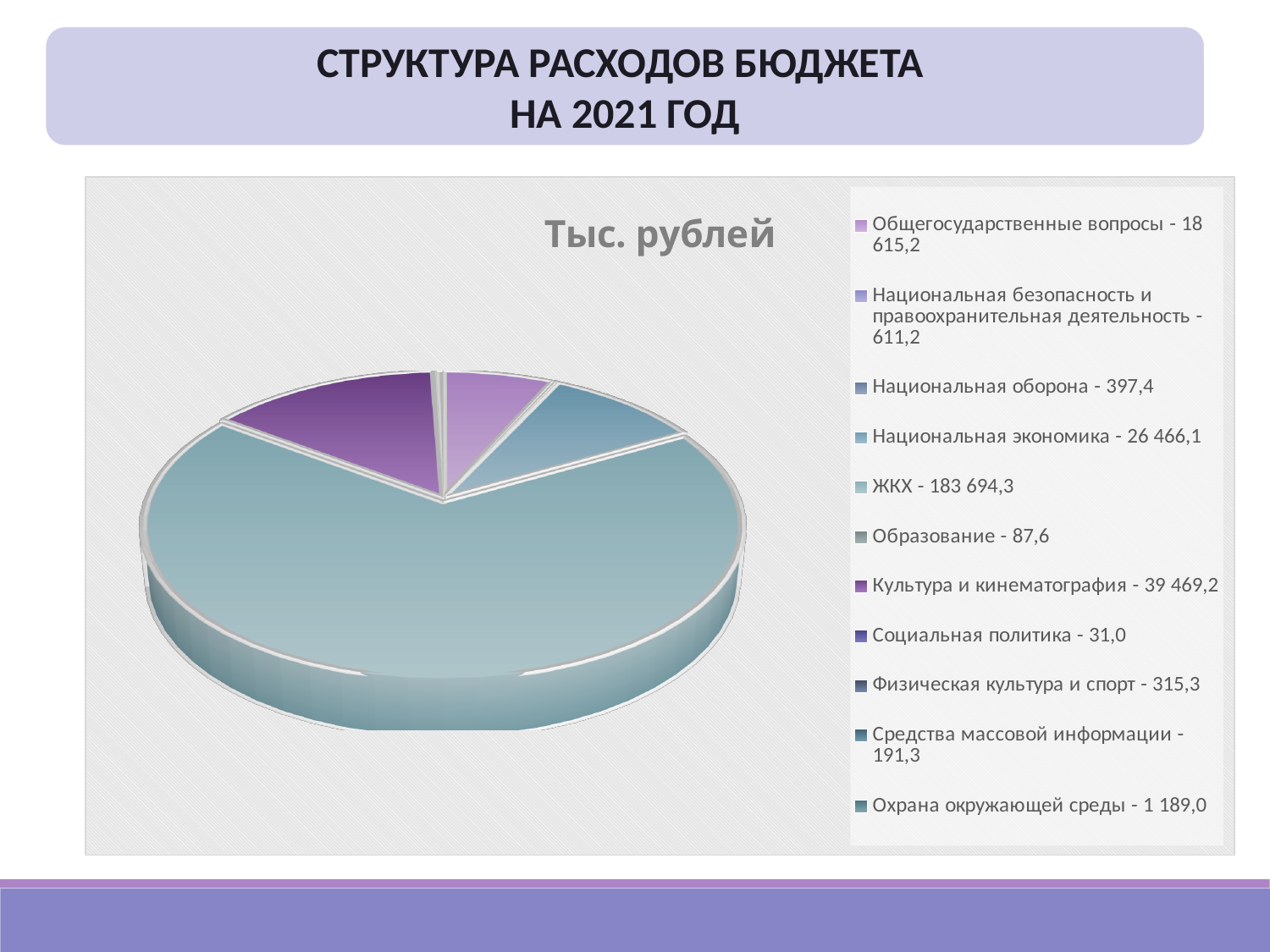
Which category has the largest value? ЖКХ What is the value for ЖКХ according to the legend? 183 694,3 How many categories does the legend list? 11 Which category has the smallest value? Социальная политика What is the difference between Национальная оборона and Физическая культура и спорт? 82,1 What is the difference between Национальная экономика and Общегосударственные вопросы? 7 850,9 What is the title shown above the pie chart? Тыс. рублей What is the value for Культура и кинематография? 39 469,2 What is the value for Национальная экономика? 26 466,1 What is the value for Охрана окружающей среды? 1 189,0 Which is larger: Культура и кинематография or Национальная экономика? Культура и кинематография What kind of chart is shown on the slide? Pie chart